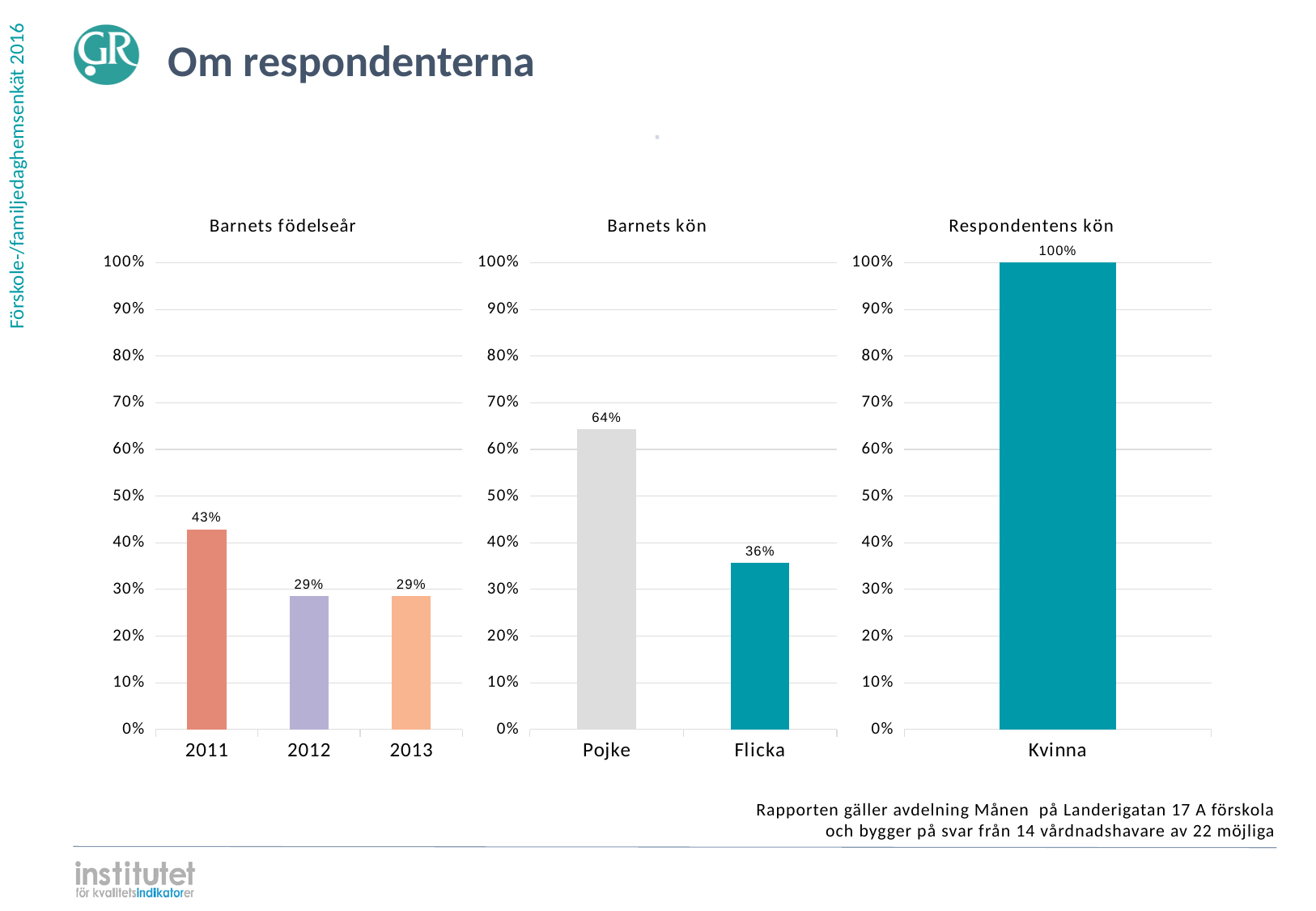
In the 'Barnets kön' chart, which category is larger, Pojke or Flicka? Pojke What kind of chart is the 'Barnets kön' chart? Bar chart In the 'Barnets födelseår' chart, how many categories are shown on the x axis? 3 In the 'Respondentens kön' chart, what is the value for Kvinna? 100% In the 'Barnets kön' chart, what is the value for Flicka? 36% In the 'Barnets kön' chart, what is the value for Pojke? 64% In the 'Barnets kön' chart, what is the difference between Pojke and Flicka? 28% In the 'Barnets födelseår' chart, which year has the highest value? 2011 In the 'Barnets födelseår' chart, what is the difference between the values for 2011 and 2012? 14% In the 'Barnets födelseår' chart, is the value for 2013 greater or less than 30%? less In the 'Barnets födelseår' chart, what is the value for 2011? 43% In the 'Respondentens kön' chart, how many categories are shown? 1